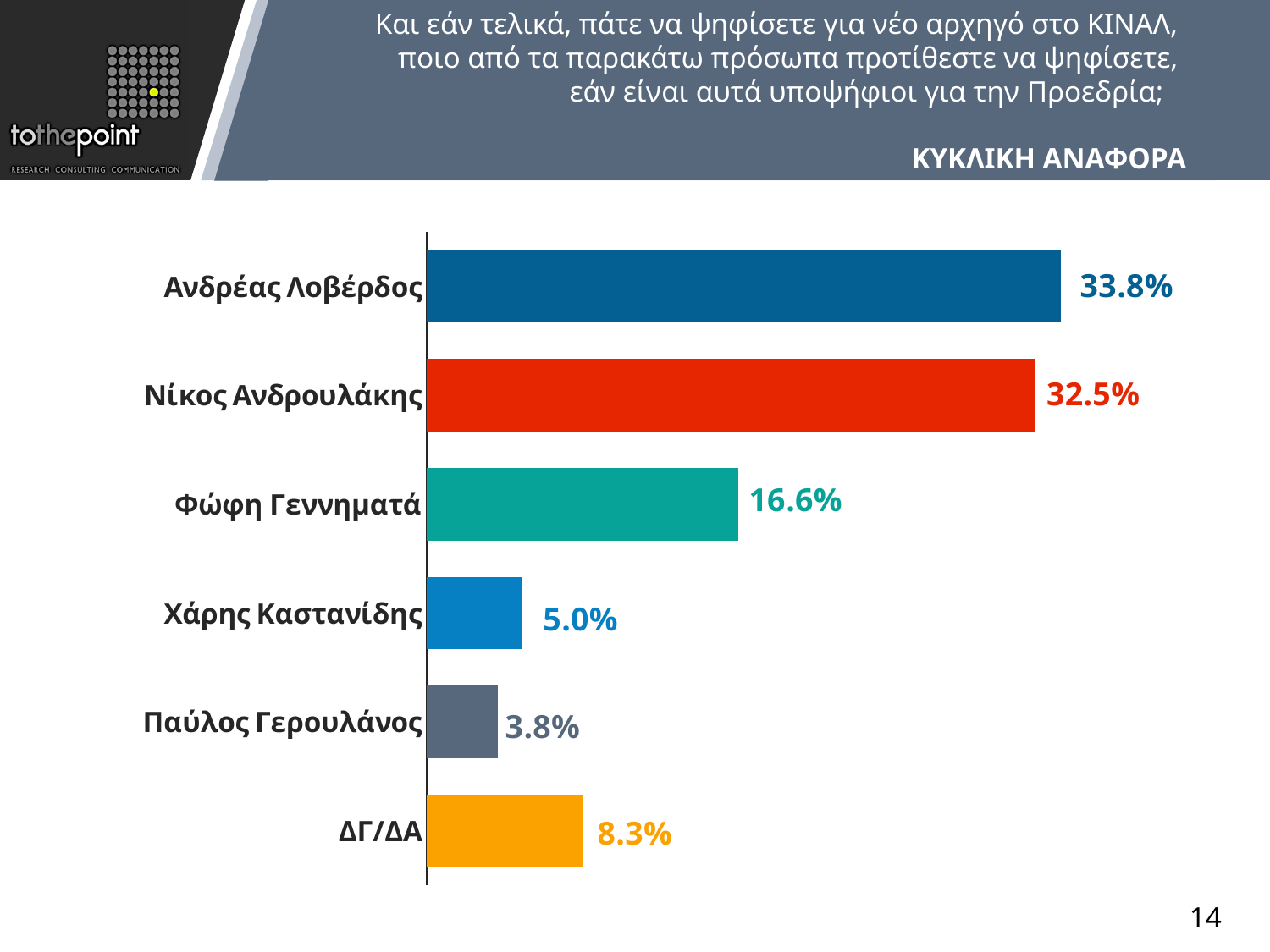
Which is larger, the value for Χάρης Καστανίδης or the value for ΔΓ/ΔΑ? ΔΓ/ΔΑ How many categories are shown in the chart? 6 What kind of chart is shown on the slide? Bar chart What is the value for Ανδρέας Λοβέρδος? 33.8% Which category has the lowest value? Παύλος Γερουλάνος What is the value for Φώφη Γεννηματά? 16.6% What is the difference between the values for Ανδρέας Λοβέρδος and Νίκος Ανδρουλάκης? 1.3% Which category has the highest value? Ανδρέας Λοβέρδος What is the value for ΔΓ/ΔΑ? 8.3% What is the value for Παύλος Γερουλάνος? 3.8% What is the difference between the values for Φώφη Γεννηματά and Χάρης Καστανίδης? 11.6% What colour is the bar for Νίκος Ανδρουλάκης? Red